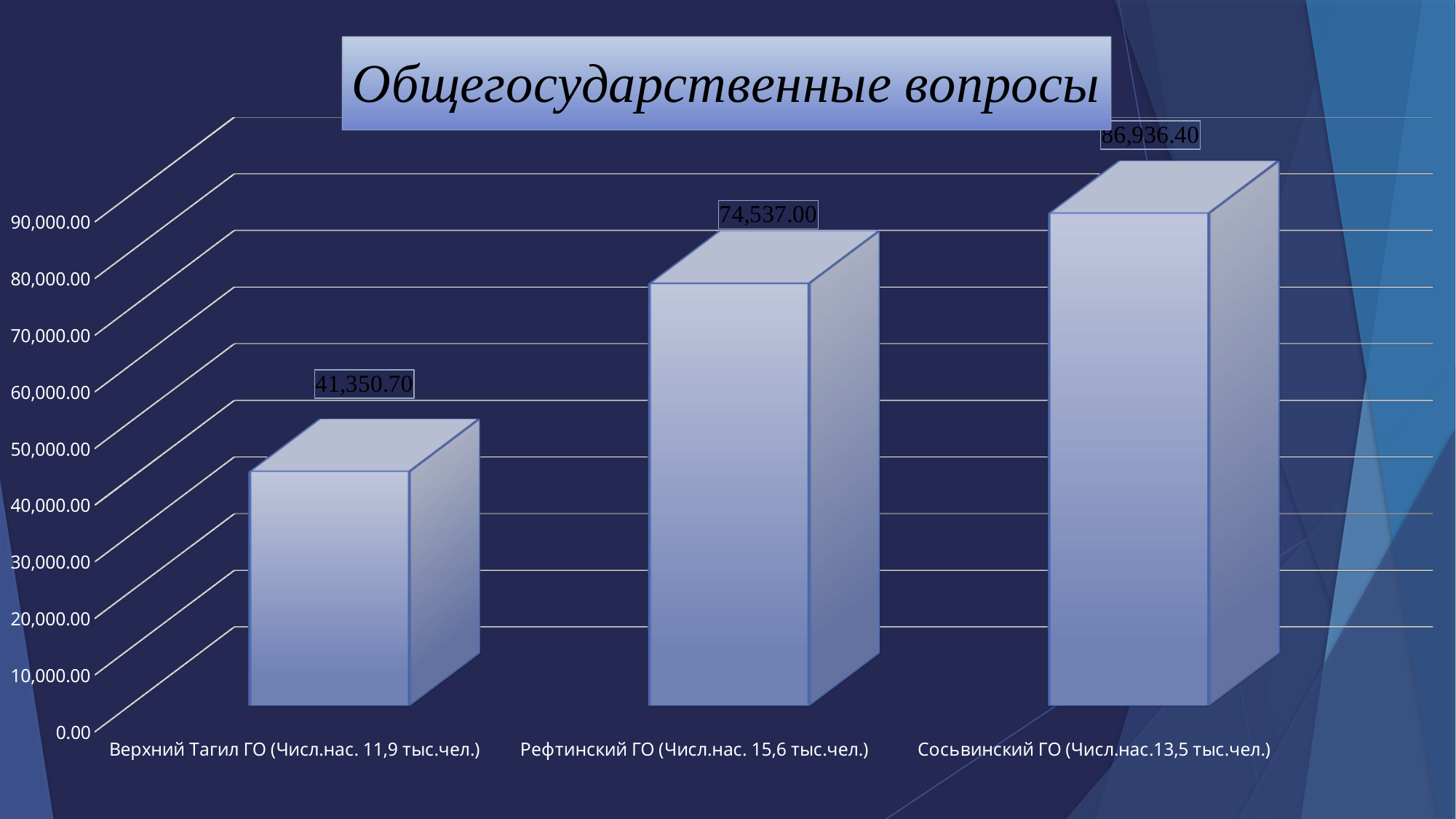
Which is larger, the value for Рефтинский ГО or the value for Верхний Тагил ГО? Рефтинский ГО What is the value for Верхний Тагил ГО? 41,350.70 What is the value for Рефтинский ГО? 74,537.00 Is the value for Верхний Тагил ГО greater or less than 50,000.00? less What is the difference between the values for Сосьвинский ГО and Рефтинский ГО? 12,399.40 What kind of chart is shown on the slide? bar chart How many categories are shown in the chart? 3 Which category has the highest value? Сосьвинский ГО What is the difference between the values for Рефтинский ГО and Верхний Тагил ГО? 33,186.30 What is the title of the chart? Общегосударственные вопросы Which category has the lowest value? Верхний Тагил ГО What is the value for Сосьвинский ГО? 86,936.40